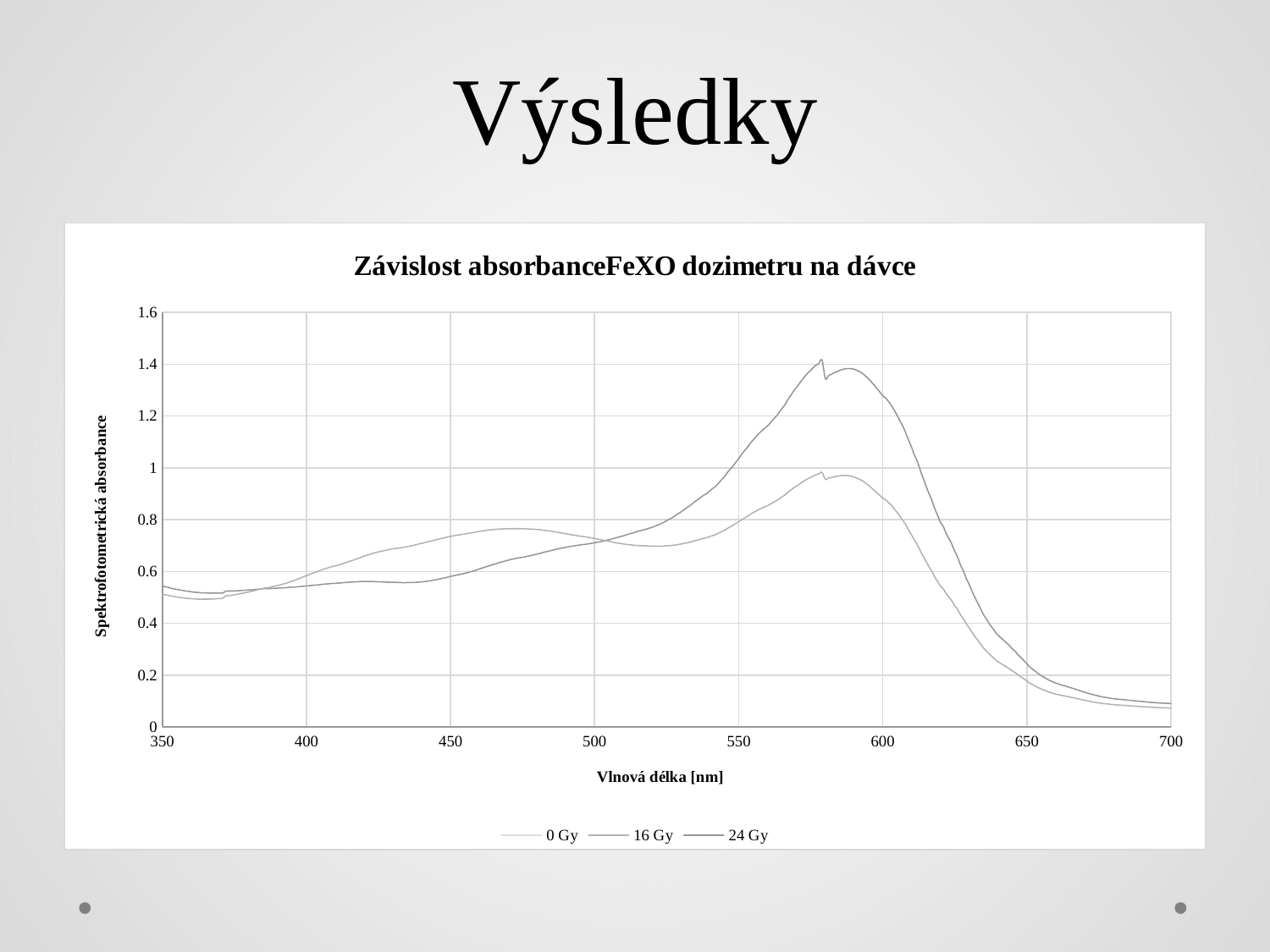
What are the three series named in the legend? 0 Gy, 16 Gy, 24 Gy What is the highest value shown on the y axis? 1.6 Is the peak of the lower curve greater or less than 0.8? greater How many tick labels are shown on the x axis? 8 What is the title of the chart? Závislost absorbanceFeXO dozimetru na dávce Is the highest peak of the upper curve greater or less than 1.2? greater Do the absorbance values rise or fall between 600 nm and 700 nm? fall What is the label of the x axis? Vlnová délka [nm] How many series does the legend list? 3 What is the range of wavelengths shown on the x axis? 350 to 700 What kind of chart is shown on the slide? line chart At 700 nm, are the plotted absorbance values greater or less than 0.2? less